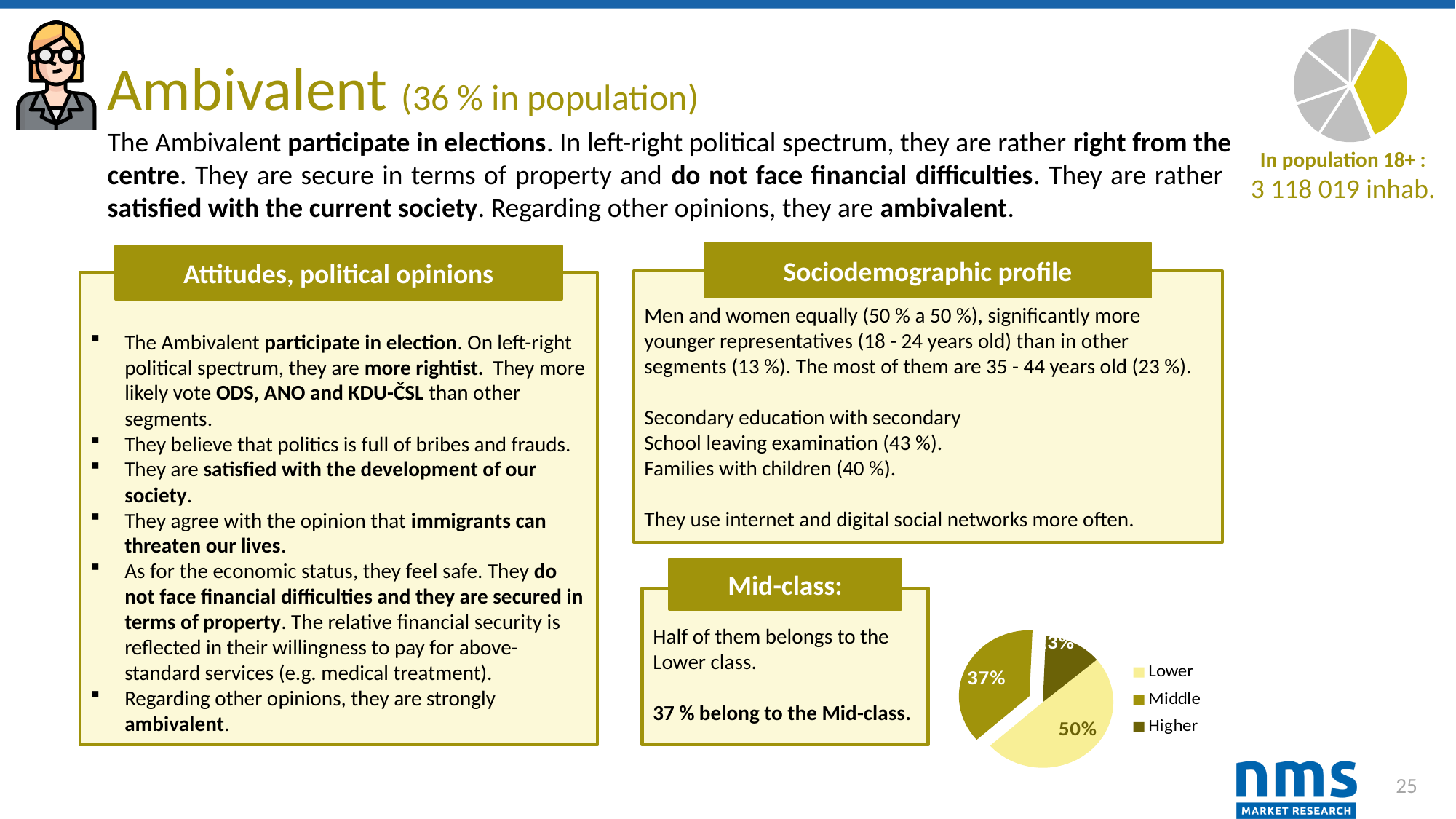
In the Mid-class pie chart, which slice is larger: Lower or Middle? Lower How many slices does the Mid-class pie chart have? 3 In the Mid-class pie chart, by how many percentage points does the Lower slice exceed the Middle slice? 13 percentage points What are the legend entries of the Mid-class pie chart? Lower, Middle, Higher In the Mid-class pie chart, what share belongs to the Lower class? 50% What type of chart is shown in the bottom right of the slide? Pie chart In the Mid-class pie chart, which class has the smallest slice? Higher In the Mid-class pie chart, what share belongs to the Middle class? 37% In the Mid-class pie chart, which class has the largest slice? Lower How many entries does the legend of the Mid-class pie chart list? 3 In the Mid-class pie chart, which class is shown in the lightest yellow colour? Lower